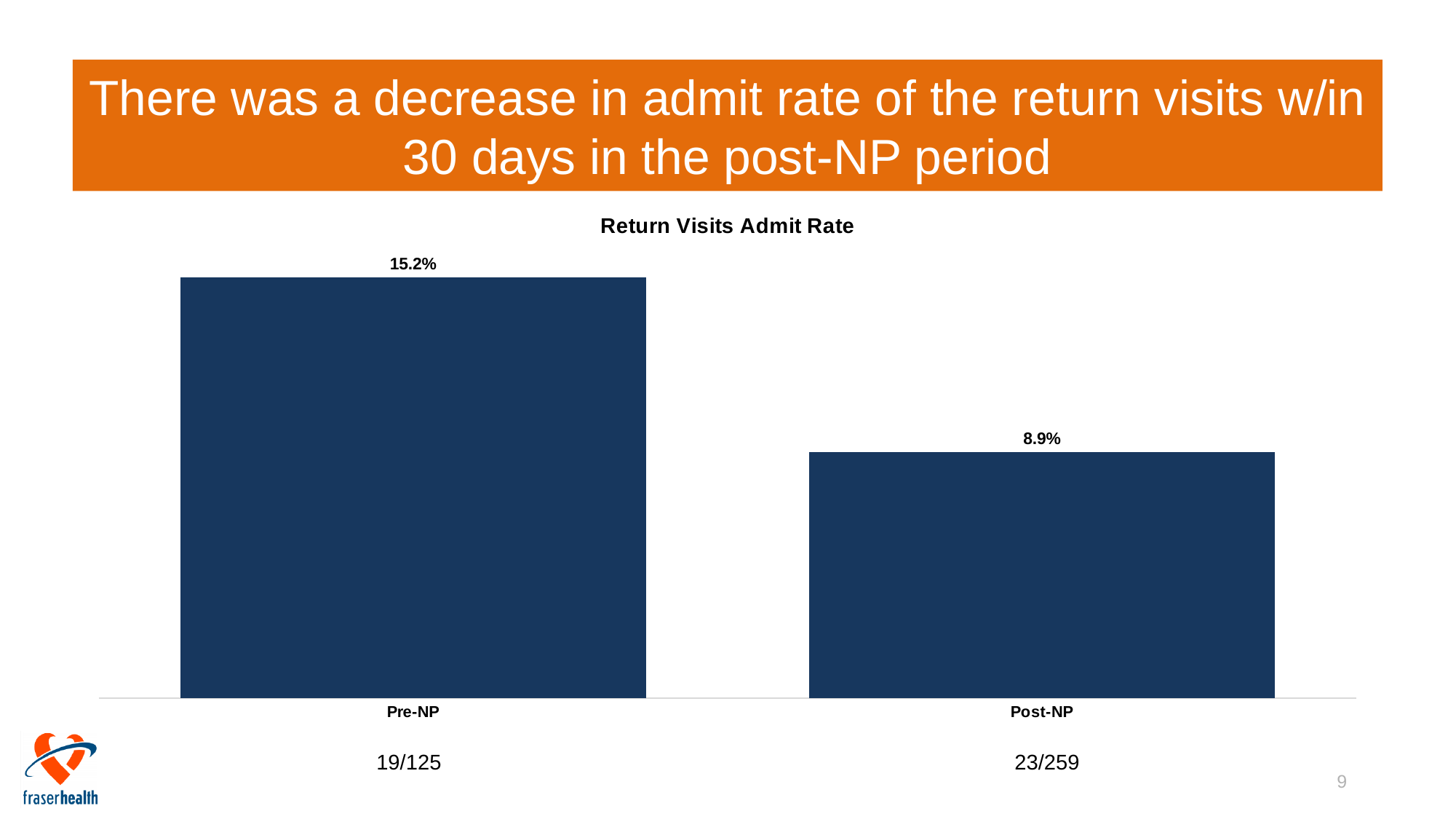
What is the return visits admit rate for Post-NP? 8.9% Which category has the higher admit rate? Pre-NP Do the values rise or fall from Pre-NP to Post-NP? fall What is the title of the chart? Return Visits Admit Rate What is the difference in admit rate between Pre-NP and Post-NP? 6.3% Which category has the lower admit rate? Post-NP What is the return visits admit rate for Pre-NP? 15.2% How many categories are shown on the chart? 2 What kind of chart is shown on the slide? bar chart Is the admit rate for Post-NP larger or smaller than for Pre-NP? smaller What fraction is shown below the Pre-NP bar? 19/125